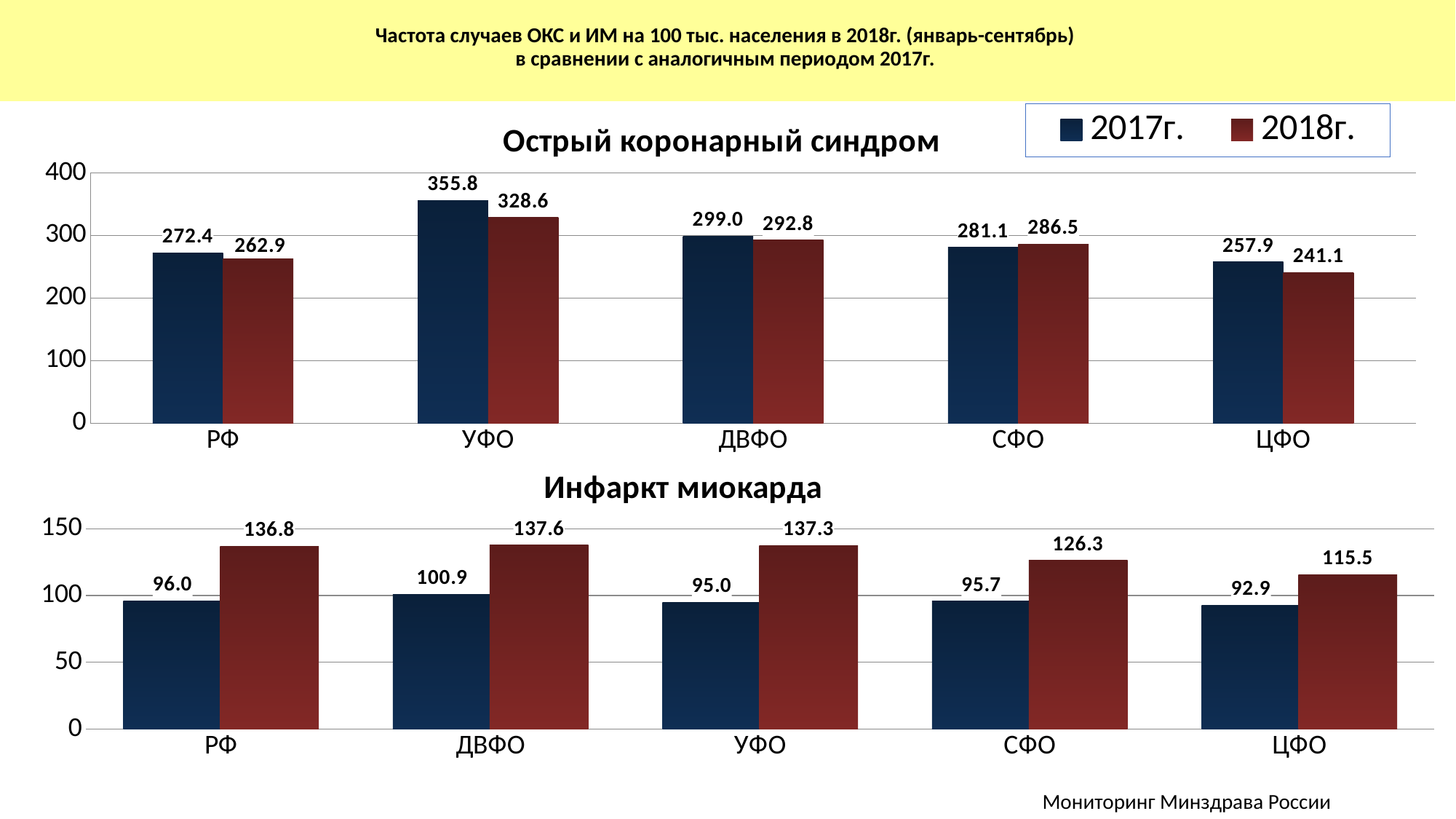
In the "Инфаркт миокарда" chart, what is the value for СФО in 2018г.? 126.3 In the "Острый коронарный синдром" chart, what is the difference between the 2017г. and 2018г. values for УФО? 27.2 In the "Инфаркт миокарда" chart, which category has the highest 2018г. value? ДВФО How many series does the legend list for the charts on this slide? 2 In the "Острый коронарный синдром" chart, what is the value for ЦФО in 2018г.? 241.1 In the "Острый коронарный синдром" chart, which category has the lowest 2018г. value? ЦФО In the "Острый коронарный синдром" chart, what is the value for УФО in 2017г.? 355.8 In the "Инфаркт миокарда" chart, what is the difference between the 2018г. and 2017г. values for ЦФО? 22.6 In the "Острый коронарный синдром" chart, is the 2017г. value for СФО greater or less than 300? less In the "Инфаркт миокарда" chart, which is larger for РФ: the 2017г. value or the 2018г. value? 2018г. How many categories are shown on the x axis of the "Инфаркт миокарда" chart? 5 In the "Острый коронарный синдром" chart, which category has the highest 2017г. value? УФО